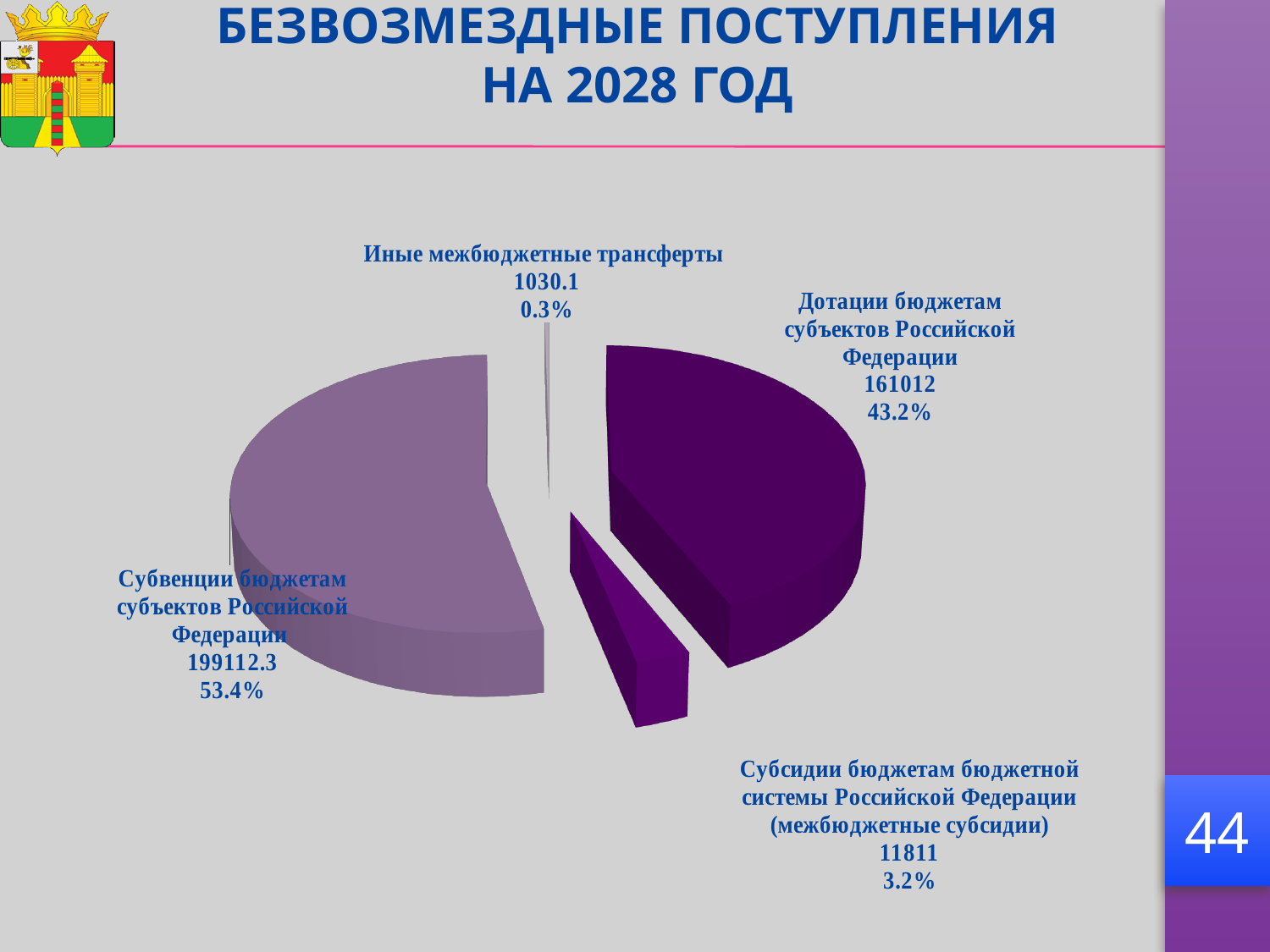
Which category has the smallest slice of the pie? Иные межбюджетные трансферты What is the value for Субвенции бюджетам субъектов Российской Федерации? 199112.3 Which is larger: the value for Субсидии бюджетам бюджетной системы Российской Федерации (межбюджетные субсидии) or the value for Иные межбюджетные трансферты? Субсидии бюджетам бюджетной системы Российской Федерации (межбюджетные субсидии) What share of the pie is Субвенции бюджетам субъектов Российской Федерации? 53.4% Which category has the largest slice of the pie? Субвенции бюджетам субъектов Российской Федерации What is the difference between the values for Субвенции бюджетам субъектов Российской Федерации and Дотации бюджетам субъектов Российской Федерации? 38100.3 How many slices does the pie chart have? 4 What is the title of the slide containing the pie chart? БЕЗВОЗМЕЗДНЫЕ ПОСТУПЛЕНИЯ НА 2028 ГОД What is the value for Иные межбюджетные трансферты? 1030.1 What type of chart is shown on the slide? pie chart What share of the pie is Субсидии бюджетам бюджетной системы Российской Федерации (межбюджетные субсидии)? 3.2% What is the value for Дотации бюджетам субъектов Российской Федерации? 161012